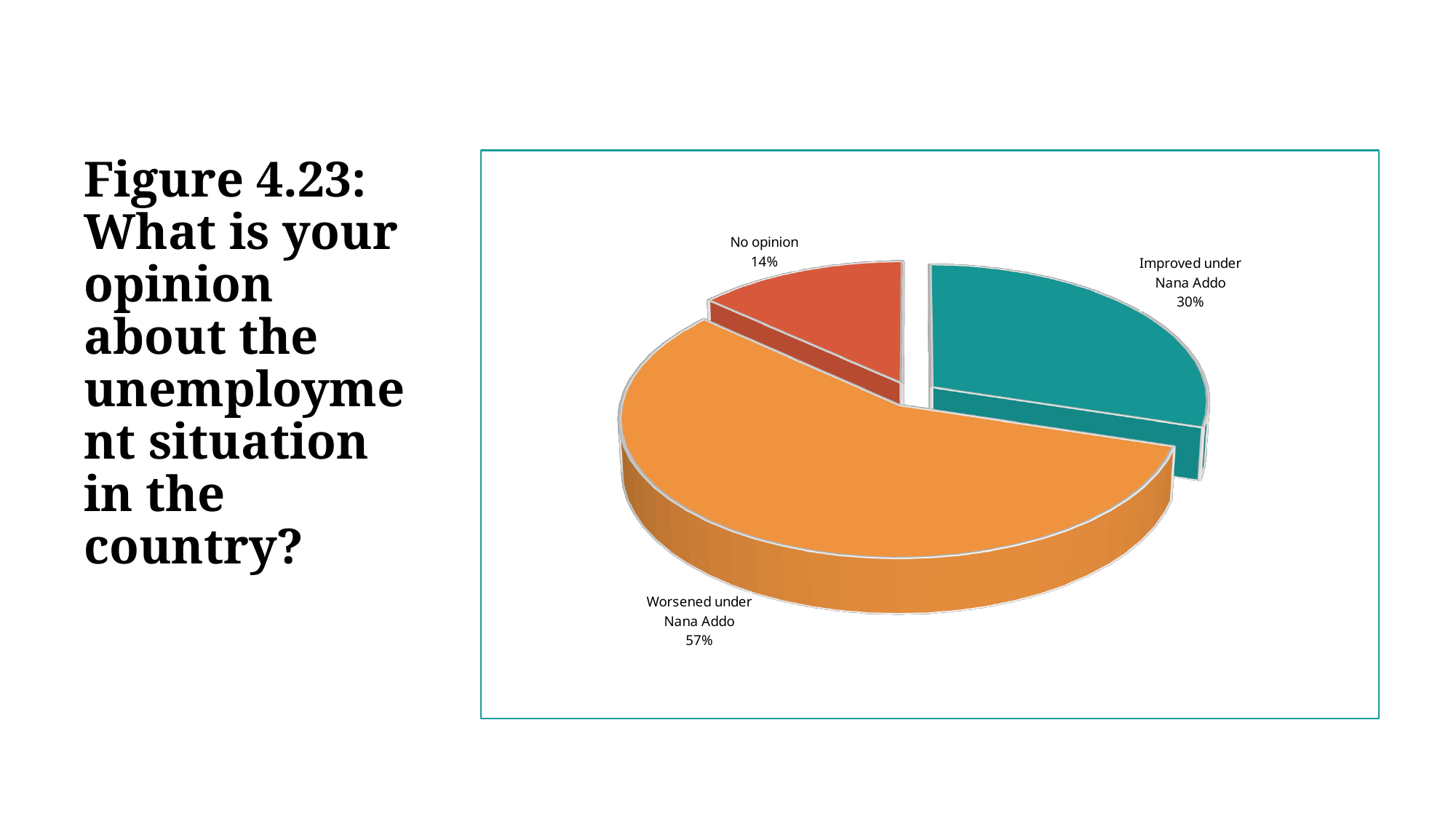
What percentage of respondents said unemployment worsened under Nana Addo? 57% Which is larger: the share for 'Improved under Nana Addo' or the share for 'No opinion'? Improved under Nana Addo What colour is the 'Worsened under Nana Addo' slice? Orange Which response has the smallest share of the pie? No opinion What is the figure number given in the slide title? Figure 4.23 Which response has the largest share of the pie? Worsened under Nana Addo How many slices does the pie chart have? 3 What is the difference in percentage points between 'Improved under Nana Addo' and 'No opinion'? 16 What share of respondents had no opinion? 14% What percentage of respondents said unemployment improved under Nana Addo? 30% What type of chart is shown on the slide? Pie chart What is the difference in percentage points between 'Worsened under Nana Addo' and 'Improved under Nana Addo'? 27